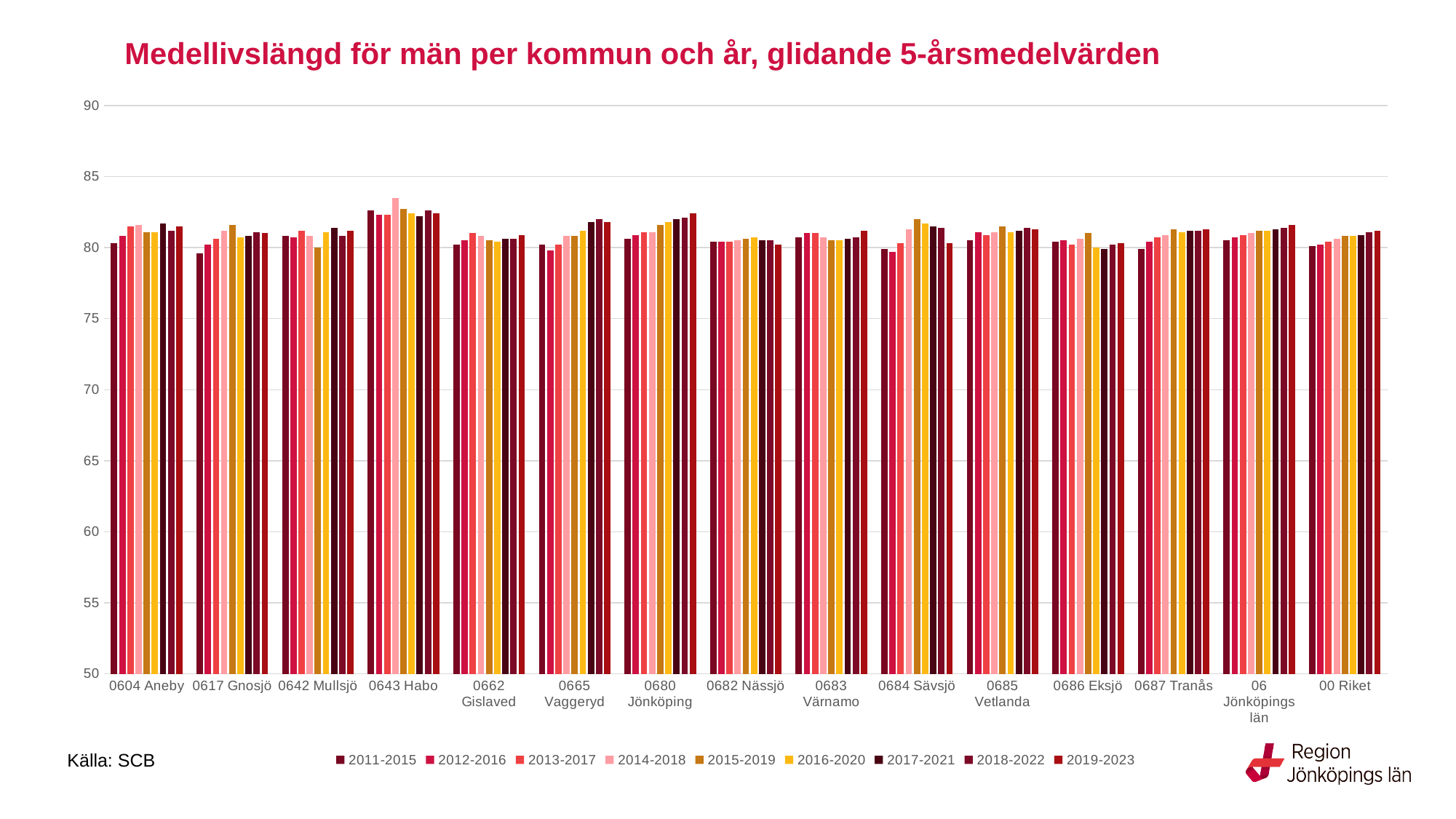
Is the value for 00 Riket in 2019-2023 greater or less than 85? less How many series does the legend list? 9 What kind of chart is shown on the slide? bar chart How many categories are shown along the x axis? 15 What is the first series listed in the legend? 2011-2015 Is the value for 0643 Habo in 2014-2018 greater or less than 80? greater Is the value for 0617 Gnosjö in 2011-2015 greater or less than 80? less What is the title of the chart? Medellivslängd för män per kommun och år, glidande 5-årsmedelvärden Which category has the highest bars overall? 0643 Habo What source is cited for the chart data? SCB Which is larger: the value for 0643 Habo in 2014-2018 or the value for 0617 Gnosjö in 2011-2015? 0643 Habo in 2014-2018